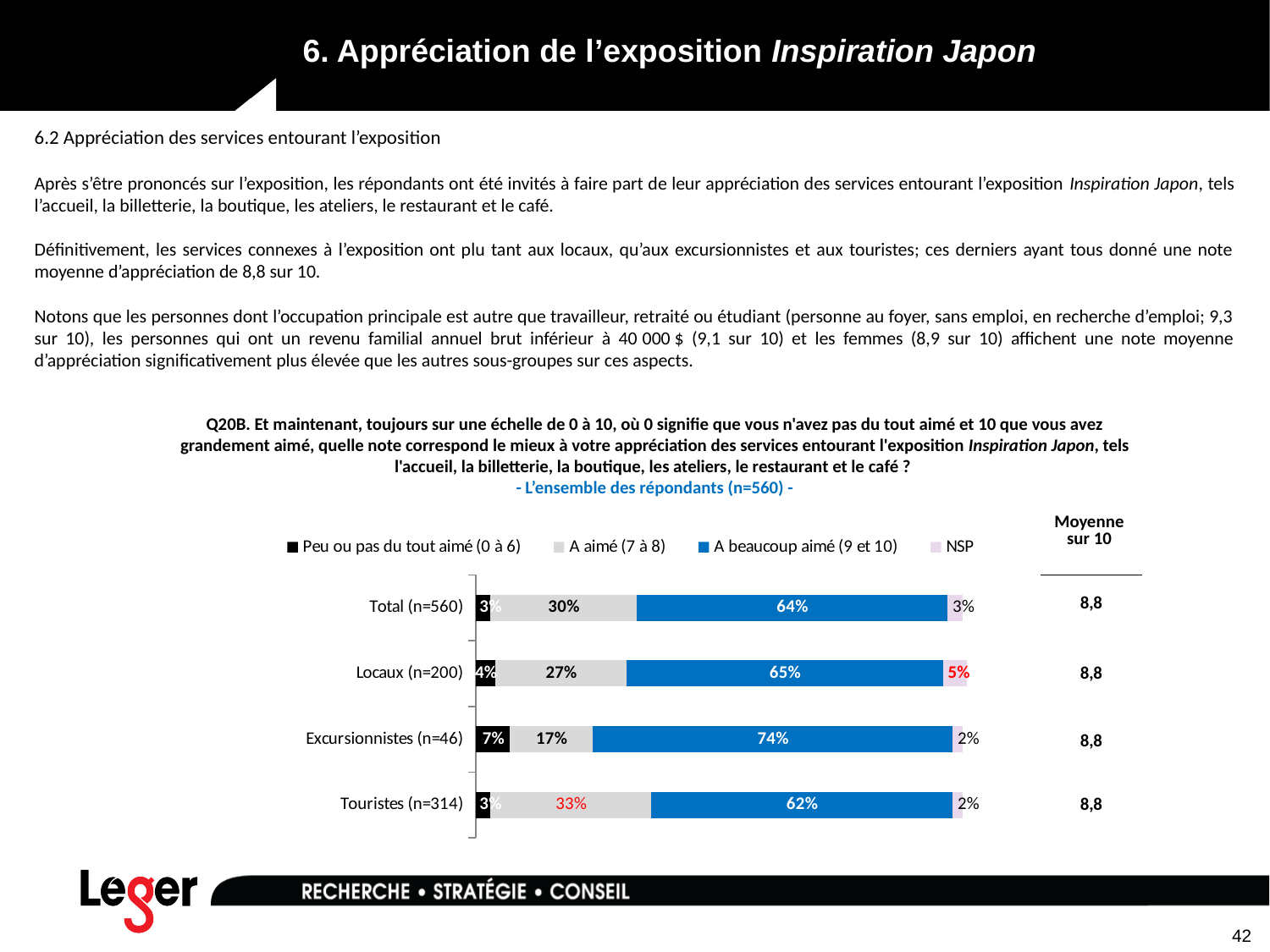
What percentage of Excursionnistes (n=46) answered "A beaucoup aimé (9 et 10)"? 74% What is the difference in percentage points between the "A beaucoup aimé (9 et 10)" share for Excursionnistes (n=46) and for Touristes (n=314)? 12 How many groups (bars) are shown in the chart? 4 What percentage of Touristes (n=314) answered "NSP"? 2% Which legend entry is shown in blue? A beaucoup aimé (9 et 10) What percentage of Locaux (n=200) answered "A aimé (7 à 8)"? 27% Which group has the lowest share of "A aimé (7 à 8)"? Excursionnistes (n=46) Which group has the highest share of "A beaucoup aimé (9 et 10)"? Excursionnistes (n=46) What type of chart is shown on the slide? Stacked bar chart How many series does the legend list? 4 Which is larger: the "Peu ou pas du tout aimé (0 à 6)" share for Locaux (n=200) or for Excursionnistes (n=46)? Excursionnistes (n=46) What is the "Moyenne sur 10" shown for Total (n=560)? 8,8